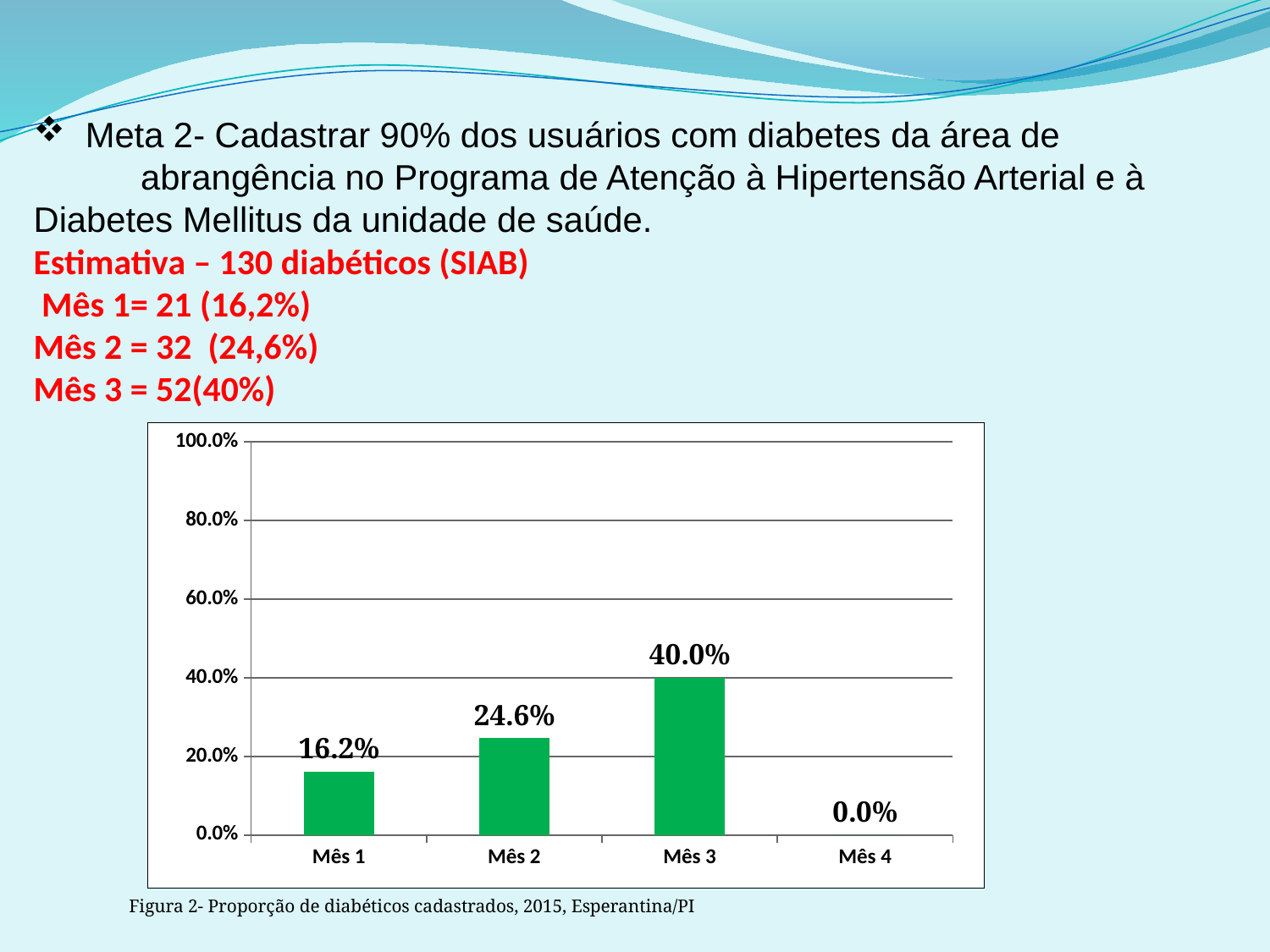
What is the difference between the values for Mês 3 and Mês 1? 23.8% What is the value for Mês 2? 24.6% Which is larger, the value for Mês 2 or the value for Mês 3? Mês 3 How many categories are shown on the x axis? 4 What is the value for Mês 4? 0.0% What is the value for Mês 3? 40.0% What kind of chart is shown? Bar chart What is the difference between the values for Mês 2 and Mês 1? 8.4% What is the value for Mês 1? 16.2% Do the values rise or fall from Mês 1 to Mês 3? Rise Which month has the highest value? Mês 3 Which month has the lowest value? Mês 4